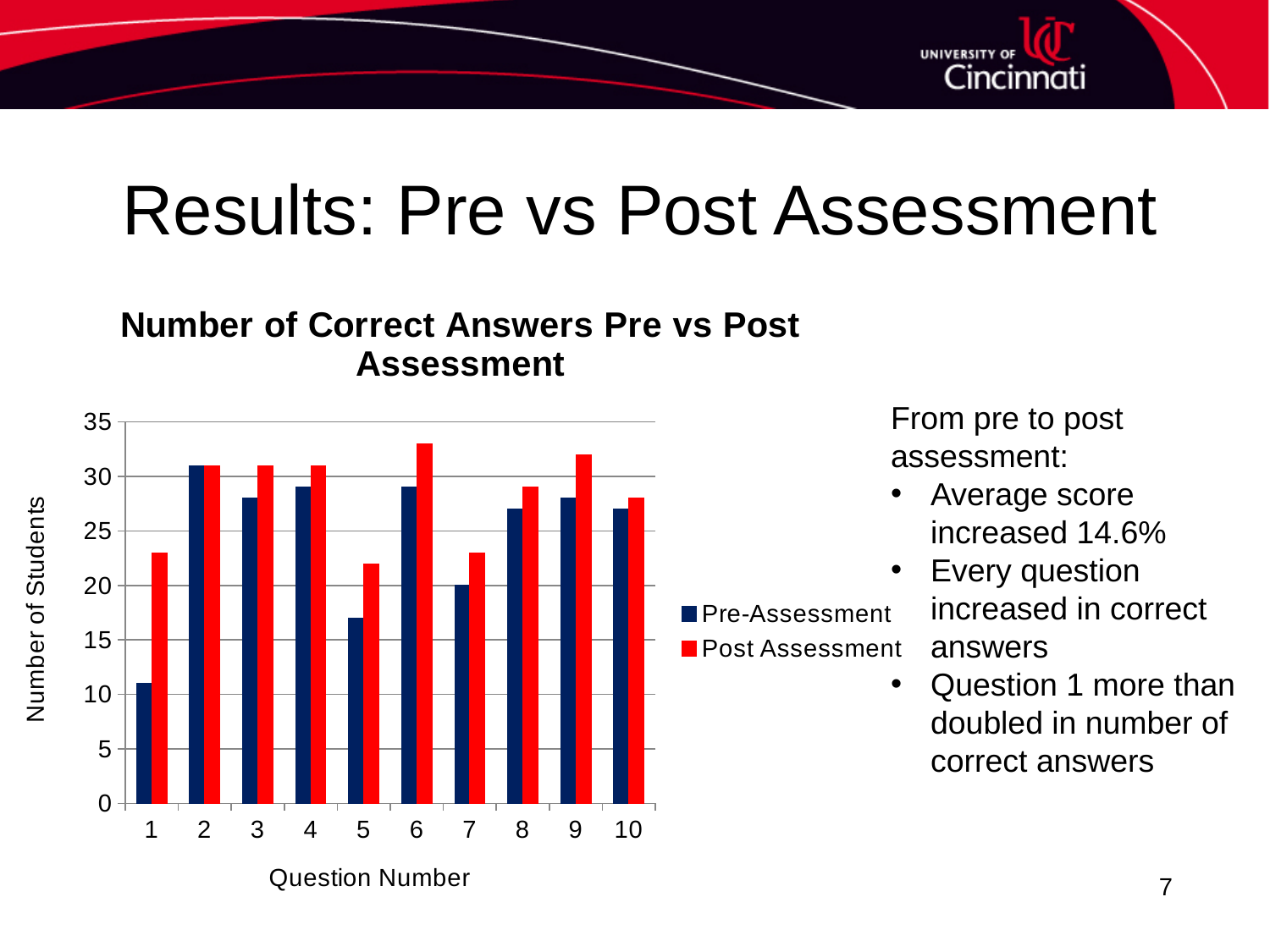
How many question numbers are shown on the x axis of the chart? 10 What kind of chart is shown on the slide? bar chart Which question number has the lowest Pre-Assessment value? 1 Which has the larger Pre-Assessment value: question 2 or question 5? question 2 How many series does the chart's legend list? 2 What is the title of the chart? Number of Correct Answers Pre vs Post Assessment What is the label of the chart's y axis? Number of Students Is the Pre-Assessment value for question 5 greater or less than 20? less For question 1, which is larger: the Pre-Assessment value or the Post Assessment value? Post Assessment Is the Pre-Assessment value for question 1 greater or less than 15? less Is the Post Assessment value for question 1 greater or less than 20? greater